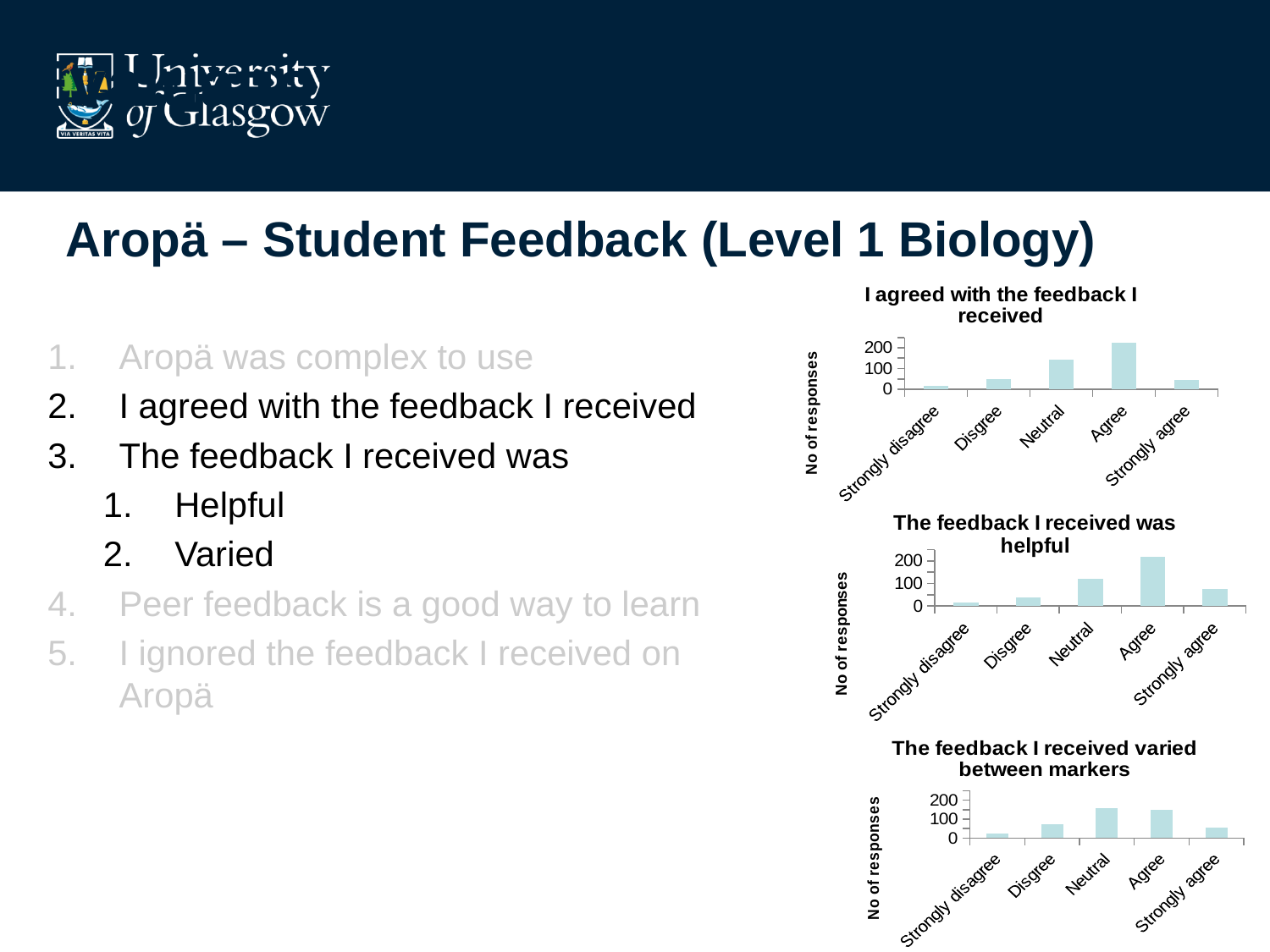
What type of chart is the chart titled "The feedback I received was helpful"? bar chart In the chart titled "The feedback I received varied between markers", which category has the lowest number of responses? Strongly disagree In the chart titled "I agreed with the feedback I received", which category has the highest number of responses? Agree In the chart titled "The feedback I received varied between markers", is the value for Neutral greater or less than 100? greater How many categories are shown on the x axis of the chart titled "I agreed with the feedback I received"? 5 In the chart titled "I agreed with the feedback I received", is the value for Agree greater or less than 200? greater In the chart titled "The feedback I received was helpful", which is larger, the value for Neutral or the value for Disagree? Neutral In the chart titled "The feedback I received was helpful", which category has the highest number of responses? Agree In the chart titled "The feedback I received varied between markers", is the value for Disagree greater or less than 100? less In the chart titled "I agreed with the feedback I received", which category has the lowest number of responses? Strongly disagree